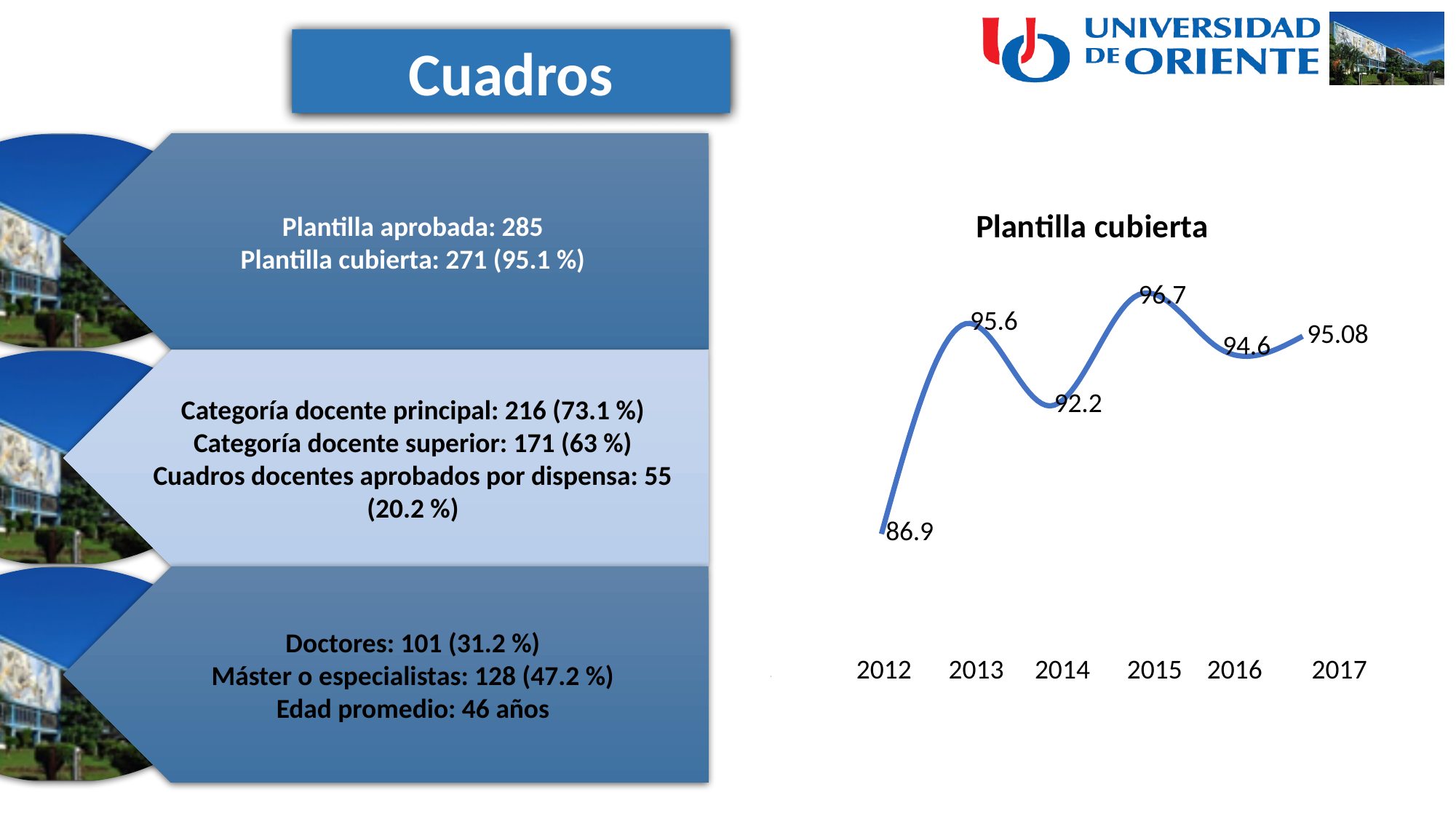
What is the value for 2014? 92.2 Which year has the highest value? 2015 What is the value for 2017? 95.08 What is the value for 2012? 86.9 Which year has the lowest value? 2012 What is the value for 2015? 96.7 Does the value rise or fall from 2015 to 2016? fall How many years are plotted on the chart? 6 What is the title of the chart? Plantilla cubierta What type of chart is shown on the slide? line chart What is the difference between the values for 2013 and 2012? 8.7 Which is larger, the value for 2016 or the value for 2014? 2016